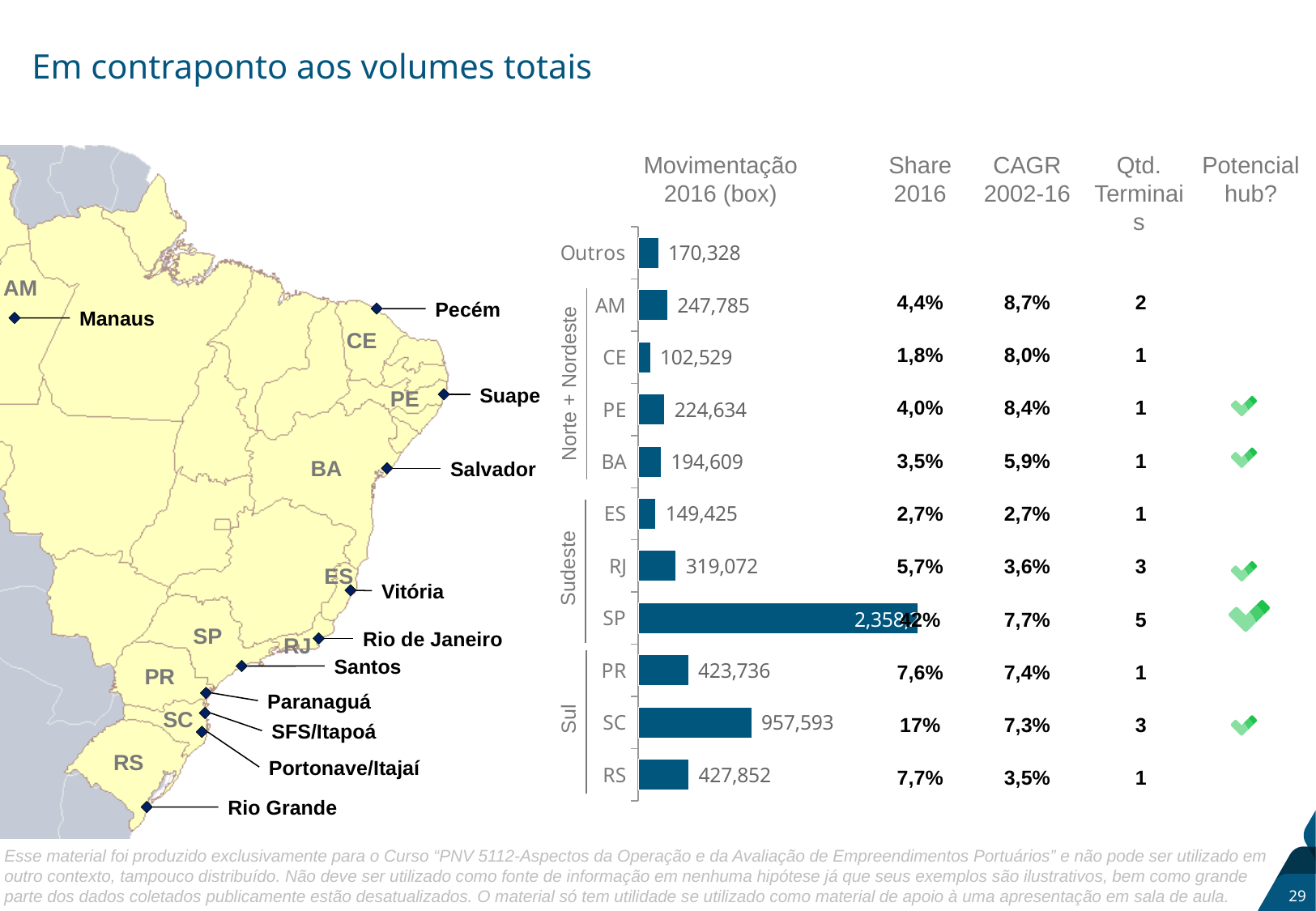
What is the Movimentação 2016 (box) value for AM? 247,785 How many categories are plotted in the Movimentação 2016 (box) bar chart? 11 Which category has the highest Movimentação 2016 (box) value? SP What is the Movimentação 2016 (box) value for RJ? 319,072 What kind of chart shows the Movimentação 2016 (box) values? bar chart Which three regional groups are the bar chart categories organised into? Norte + Nordeste, Sudeste, Sul Which has a larger Movimentação 2016 (box) value, SC or PR? SC What is the Movimentação 2016 (box) value for SC? 957,593 Which category has the lowest Movimentação 2016 (box) value? CE What is the difference between the Movimentação 2016 (box) values for RS and PR? 4,116 What is the difference between the Movimentação 2016 (box) values for PE and BA? 30,025 What is the Movimentação 2016 (box) value for Outros? 170,328